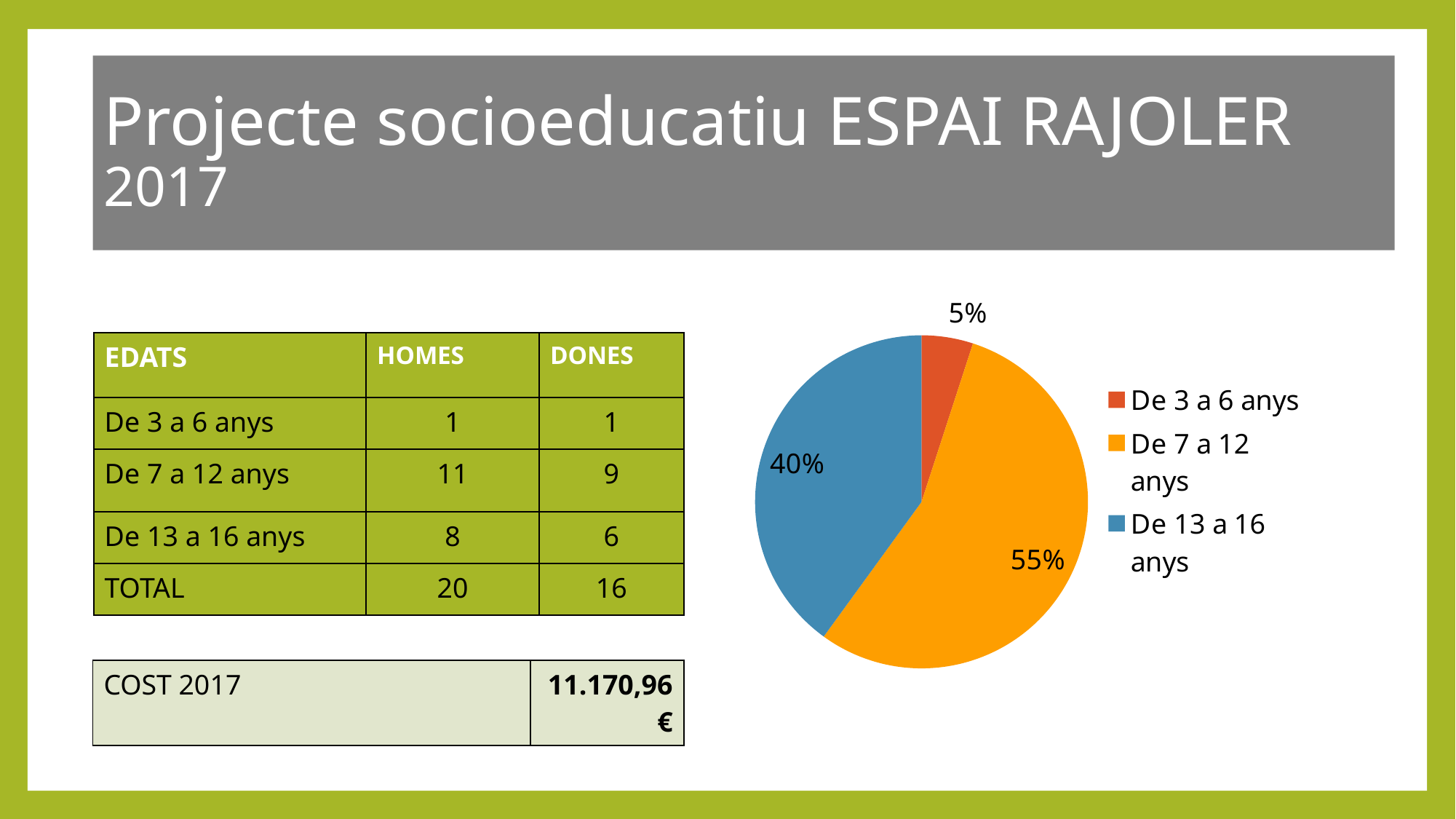
What share of the pie does "De 3 a 6 anys" represent? 5% Which slice is larger, "De 13 a 16 anys" or "De 3 a 6 anys"? De 13 a 16 anys Which age group has the largest slice of the pie? De 7 a 12 anys What kind of chart is shown on the slide? pie chart How many slices does the pie chart have? 3 What colour is the "De 13 a 16 anys" slice in the pie chart? blue What share of the pie does "De 13 a 16 anys" represent? 40% Which age group has the smallest slice of the pie? De 3 a 6 anys What is the difference in percentage points between the "De 7 a 12 anys" slice and the "De 13 a 16 anys" slice? 15% What share of the pie does "De 7 a 12 anys" represent? 55% What colour is the "De 7 a 12 anys" slice in the pie chart? orange How many entries does the legend of the pie chart list? 3